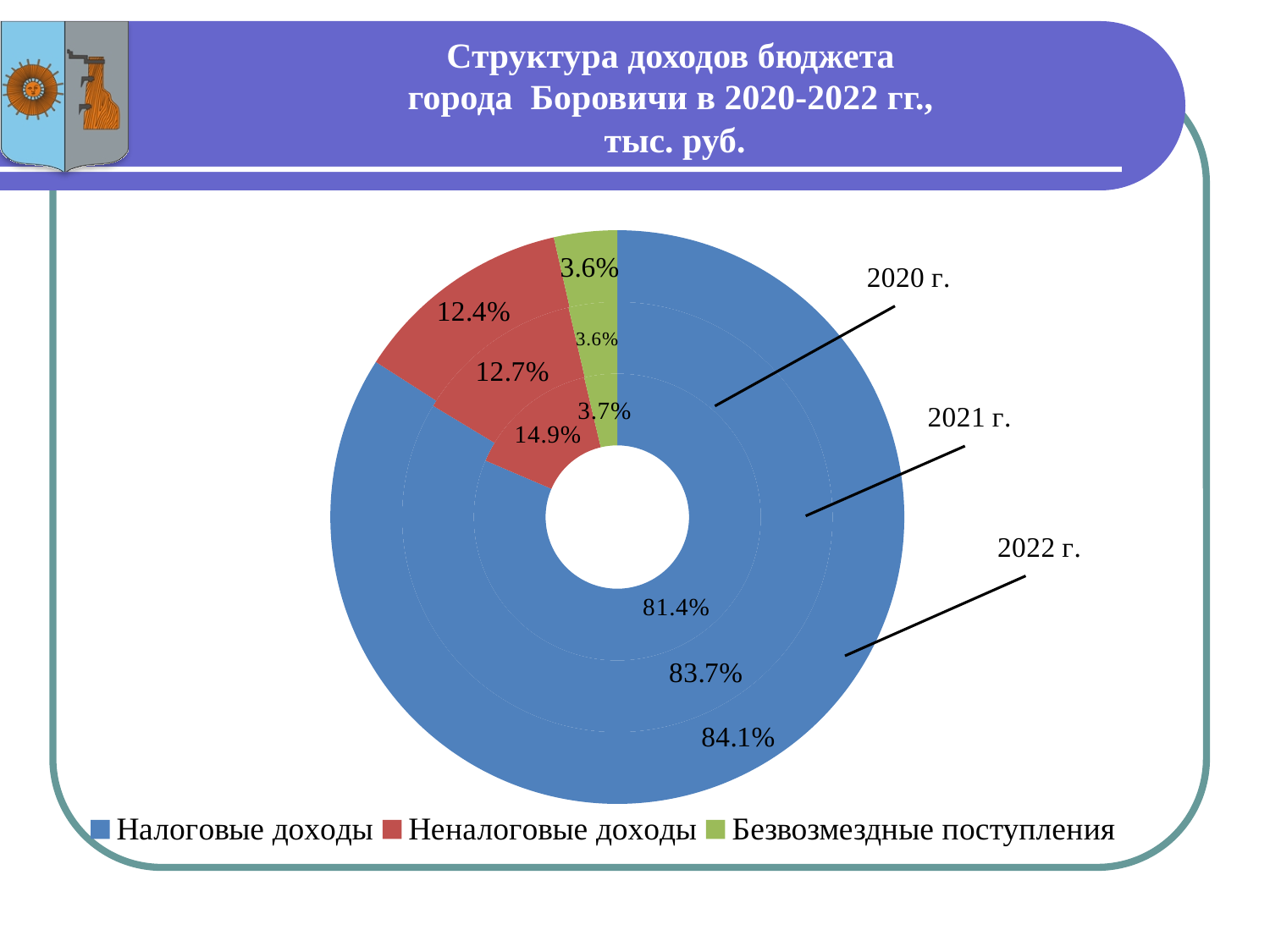
Which category has the largest share in 2021 г.? Налоговые доходы What is the difference between the share of Налоговые доходы in 2022 г. and in 2020 г.? 2.7% Which colour represents Безвозмездные поступления in the chart? Green Does the share of Налоговые доходы rise or fall from 2020 г. to 2022 г.? Rise What kind of chart is shown on the slide? Doughnut chart What is the share of Налоговые доходы in 2022 г.? 84.1% Which category has the smallest share in 2022 г.? Безвозмездные поступления What is the share of Безвозмездные поступления in 2020 г.? 3.7% How many series does the legend list? 3 What is the share of Налоговые доходы in 2020 г.? 81.4% What is the share of Неналоговые доходы in 2021 г.? 12.7% Which is larger: the share of Неналоговые доходы in 2020 г. or in 2022 г.? 2020 г.